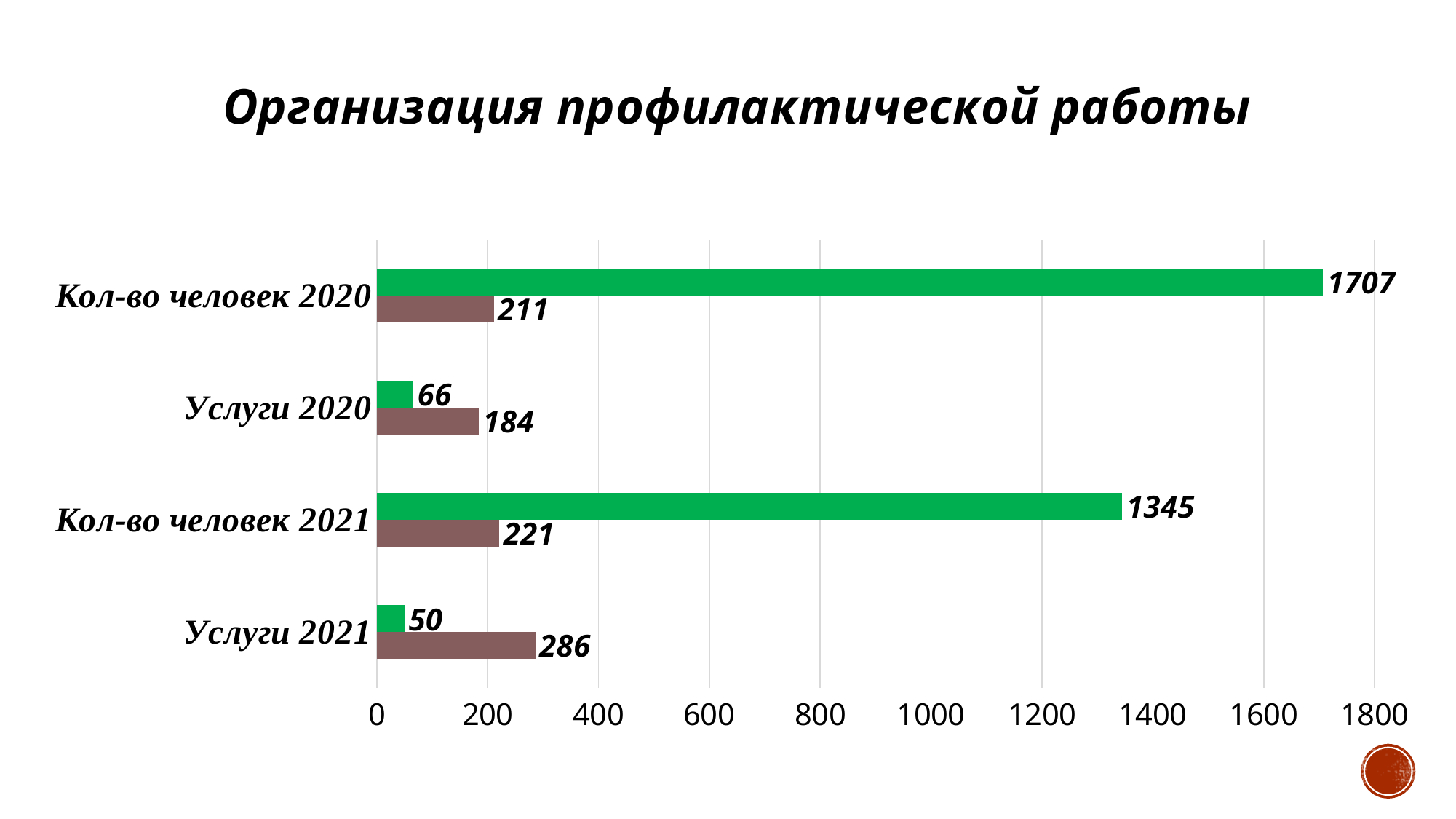
What is the difference between the green bar values for Кол-во человек 2020 and Кол-во человек 2021? 362 Which category has the highest brown bar value? Услуги 2021 Which is larger: the brown bar for Услуги 2020 or the brown bar for Услуги 2021? Услуги 2021 What is the title of the slide? Организация профилактической работы What is the value of the green bar for Кол-во человек 2020? 1707 What is the value of the brown bar for Услуги 2021? 286 What type of chart is shown on the slide? Bar chart Which category has the highest green bar value? Кол-во человек 2020 Which category has the lowest green bar value? Услуги 2021 What is the value of the green bar for Услуги 2020? 66 What is the value of the brown bar for Кол-во человек 2021? 221 How many categories are shown on the chart? 4